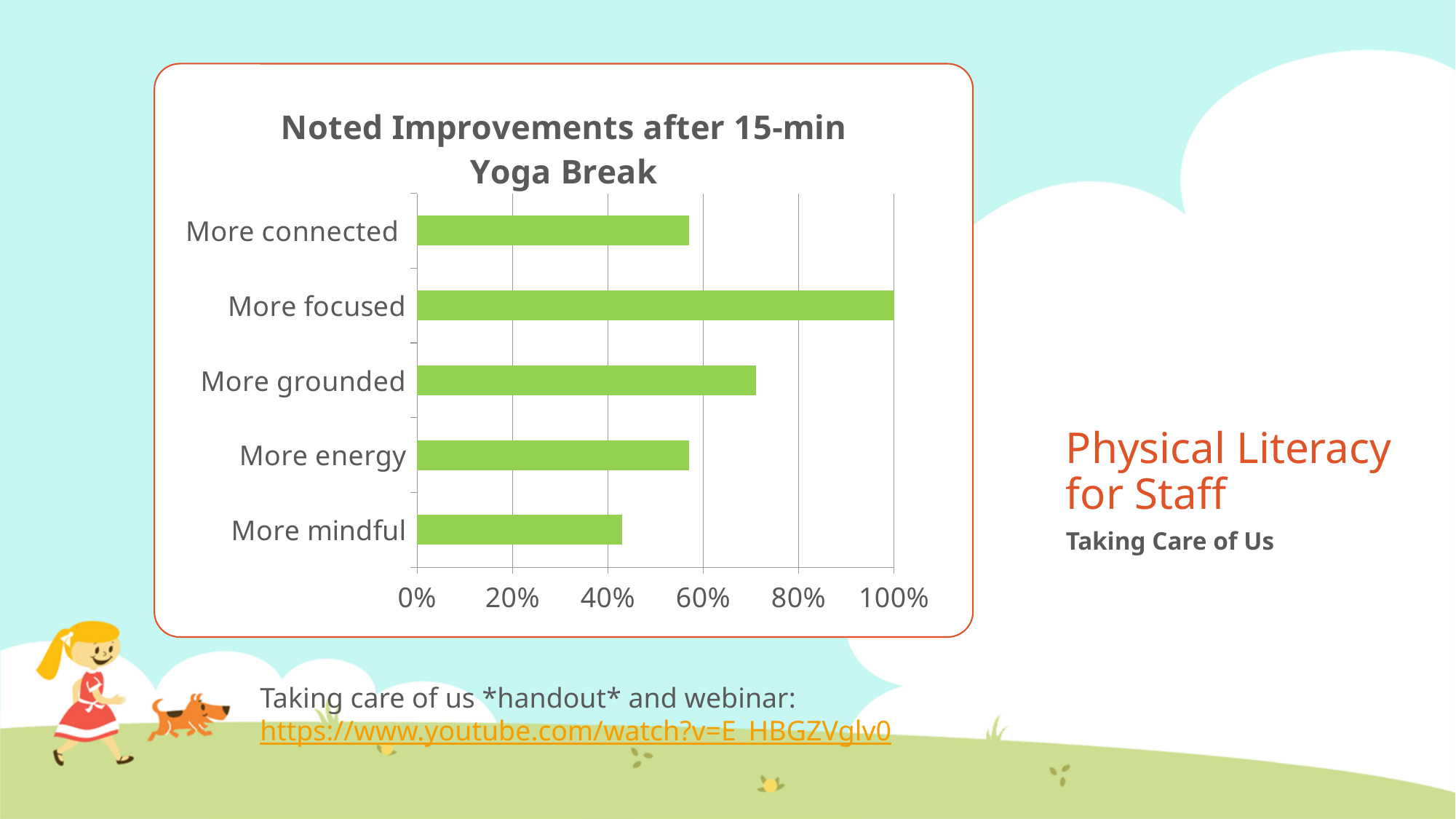
What is the value for More focused? 100% Which is larger, the value for More grounded or the value for More mindful? More grounded Is the value for More grounded greater or less than 60%? greater Which category has the lowest value? More mindful How many categories are plotted in the chart? 5 What is the title of the chart? Noted Improvements after 15-min Yoga Break Which is larger, the value for More focused or the value for More energy? More focused What kind of chart is shown on the slide? bar chart Is the value for More mindful greater or less than 60%? less Is the value for More connected greater or less than 40%? greater Which category has the highest value? More focused